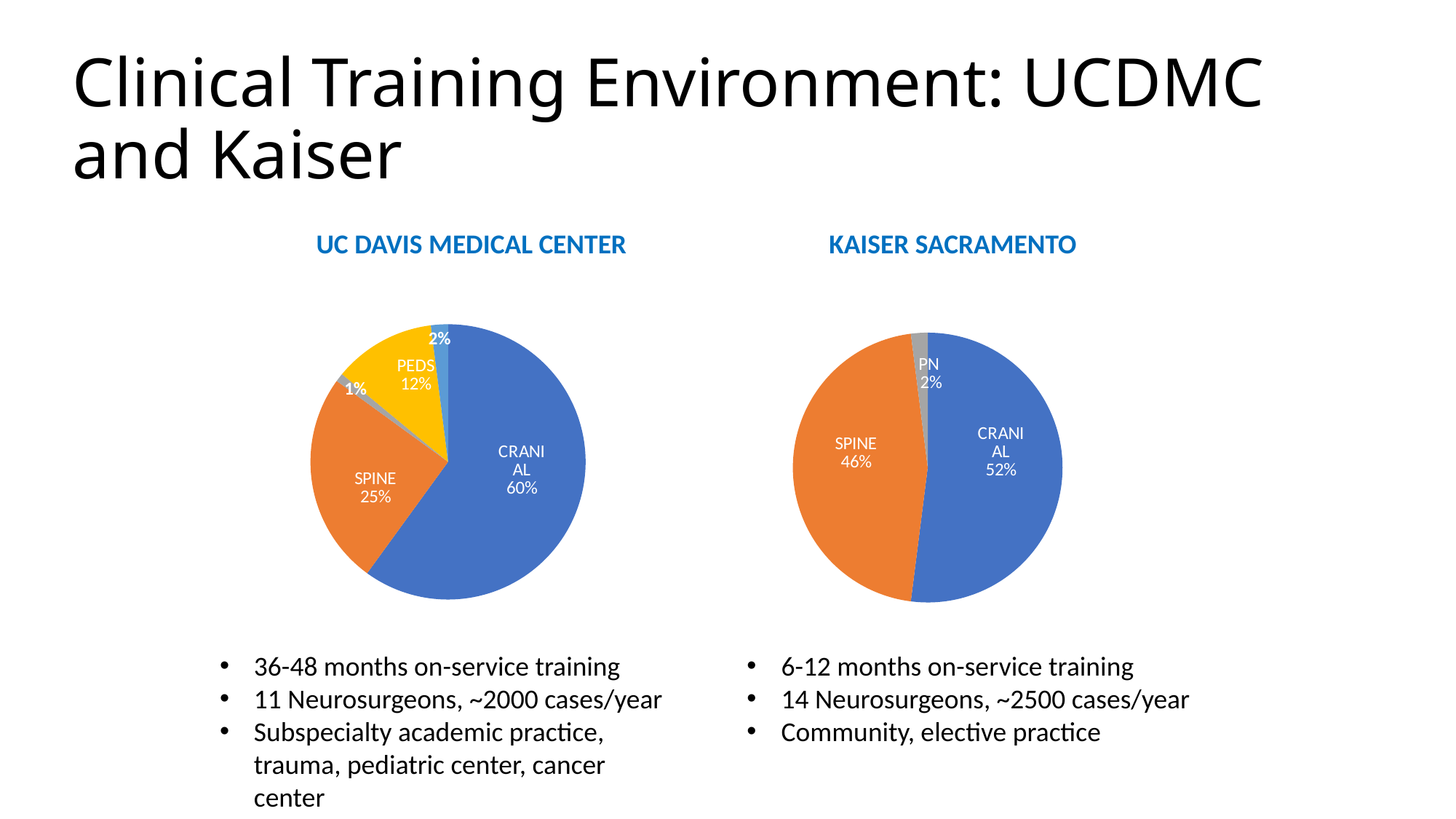
In the UC Davis Medical Center chart, what share of cases is PEDS? 12% In the UC Davis Medical Center chart, which labeled category has the largest slice? CRANIAL In the Kaiser Sacramento chart, which category has the smallest slice? PN In the Kaiser Sacramento chart, what is the difference between the CRANIAL and SPINE shares? 6% How many slices does the Kaiser Sacramento pie chart have? 3 In the Kaiser Sacramento chart, which category has the largest slice? CRANIAL In the UC Davis Medical Center chart, what share of cases is CRANIAL? 60% In the UC Davis Medical Center chart, what is the difference between the CRANIAL and SPINE shares? 35% In the Kaiser Sacramento chart, what share of cases is PN? 2% What type of chart is used for UC Davis Medical Center? Pie chart In the Kaiser Sacramento chart, what share of cases is SPINE? 46% In the UC Davis Medical Center chart, what share of cases is SPINE? 25%